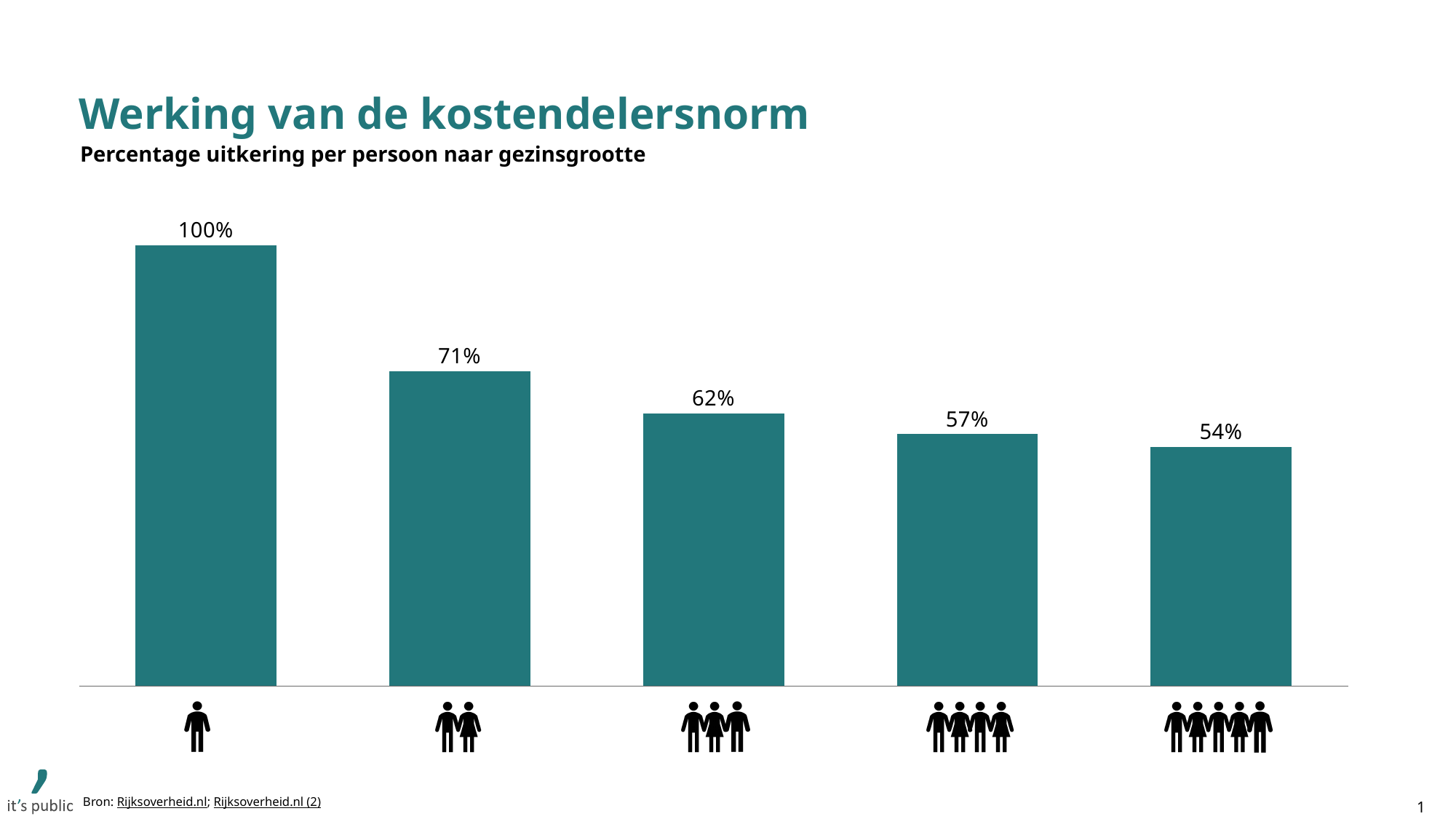
What is the difference in percentage points between the four-person and five-person households? 3 What is the difference in percentage points between the one-person and two-person households? 29 Do the percentages rise or fall as household size increases? Fall What percentage is shown for a five-person household? 54% What percentage is shown for a two-person household? 71% What percentage is shown for a three-person household? 62% Which household size has the highest percentage? One person What kind of chart is shown on the slide? Bar chart Which household size has the lowest percentage? Five persons What percentage is shown for a four-person household? 57% What percentage is shown for a one-person household? 100% How many household sizes (bars) are shown in the chart? 5